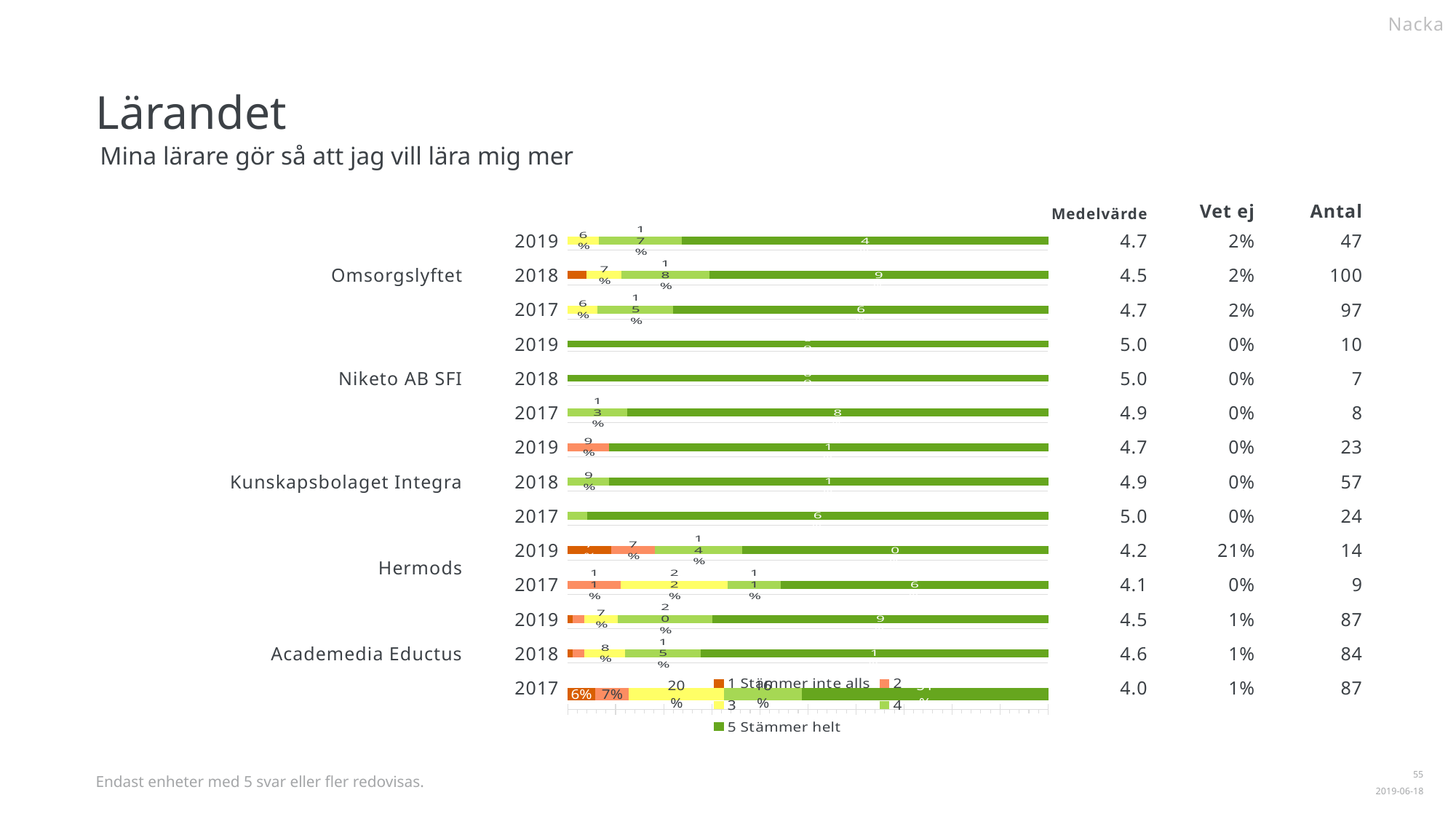
How many bars are plotted in the chart in total? 14 What is the Antal shown for Omsorgslyftet 2018? 100 What is the value of the '1 Stämmer inte alls' segment for Academedia Eductus in 2017? 6% What kind of chart is shown on the slide? bar chart How many units (schools) are shown in the chart? 5 Which unit has bars for only two years instead of three? Hermods How many series does the chart legend list? 5 What is the legend label for the dark green series? 5 Stämmer helt What is the Vet ej percentage shown for Hermods 2019? 21% What is the legend label for the dark red series? 1 Stämmer inte alls What is the Medelvärde shown for Hermods 2019? 4.2 What is the value of the '2' segment for Academedia Eductus in 2017? 7%